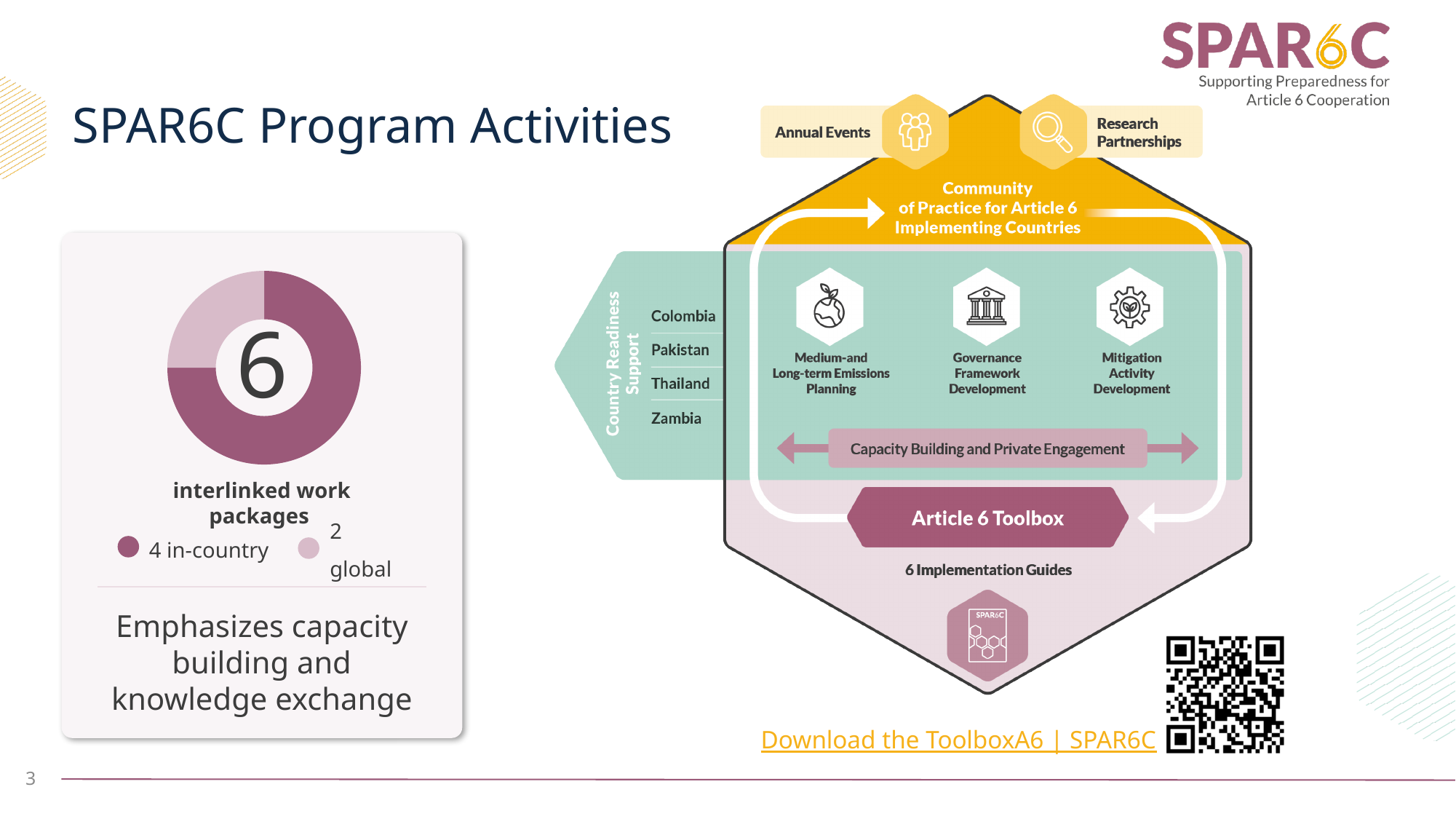
What is the total number of work packages shown in the donut chart? 6 How many categories does the donut chart show? 2 In the donut chart, how many work packages are global? 2 What is the difference between the in-country and global work package counts in the donut chart? 2 What label appears directly below the donut chart? interlinked work packages What kind of chart is shown on the left of the slide? pie chart (donut) In the donut chart, how many work packages are in-country? 4 Which category in the donut chart has the smaller value? global Is the in-country value or the global value larger in the donut chart? in-country Which category in the donut chart has the larger value? in-country What number is printed in the centre of the donut chart? 6